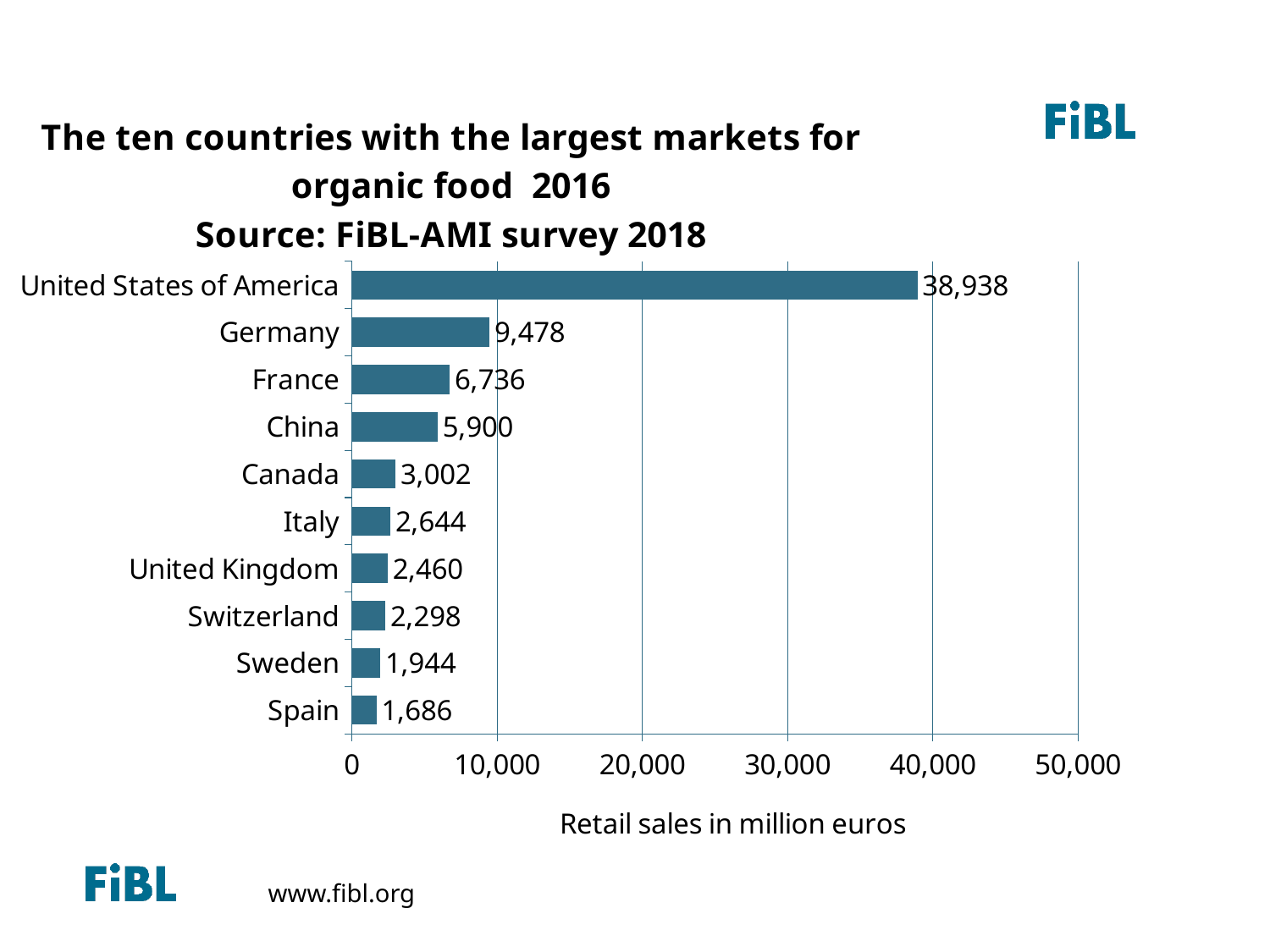
What is the retail sales value for Sweden? 1,944 Which country has the smallest value on the chart? Spain What kind of chart is shown on the slide? bar chart What is the label of the horizontal axis? Retail sales in million euros What is the difference between the values for the United States of America and Germany? 29,460 How many countries are shown on the chart? 10 What is the retail sales value for China? 5,900 Is the value for the United States of America greater or less than 40,000? less Which country has the largest organic food market? United States of America What is the difference between the values for France and China? 836 Which has a larger value, Canada or Italy? Canada What is the retail sales value for Germany? 9,478